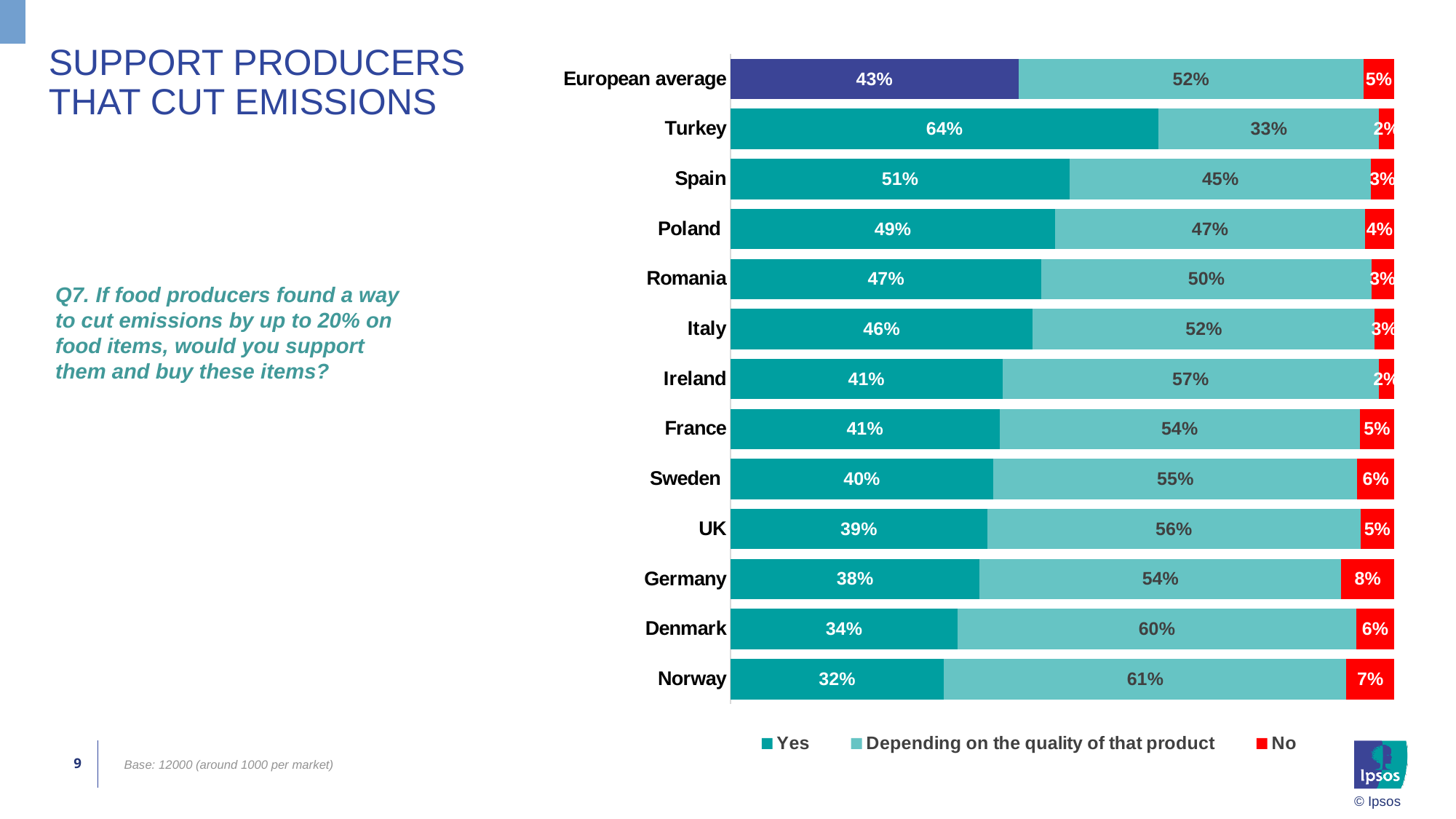
How many countries (excluding the European average) are shown in the chart? 12 How many series does the legend list? 3 What is the difference between the "Yes" values for Spain and Norway? 19% What colour represents the "No" series in the chart? Red Which country has the highest "Yes" percentage? Turkey What is the "No" value for Germany? 8% What kind of chart is shown on the slide? Stacked bar chart What percentage of respondents in Turkey answered "Yes"? 64% Which country has the lowest "Yes" percentage? Norway What is the total of the three segments for the European average bar? 100% Which has a larger "No" value, Germany or Sweden? Germany What is the "Depending on the quality of that product" value for Denmark? 60%